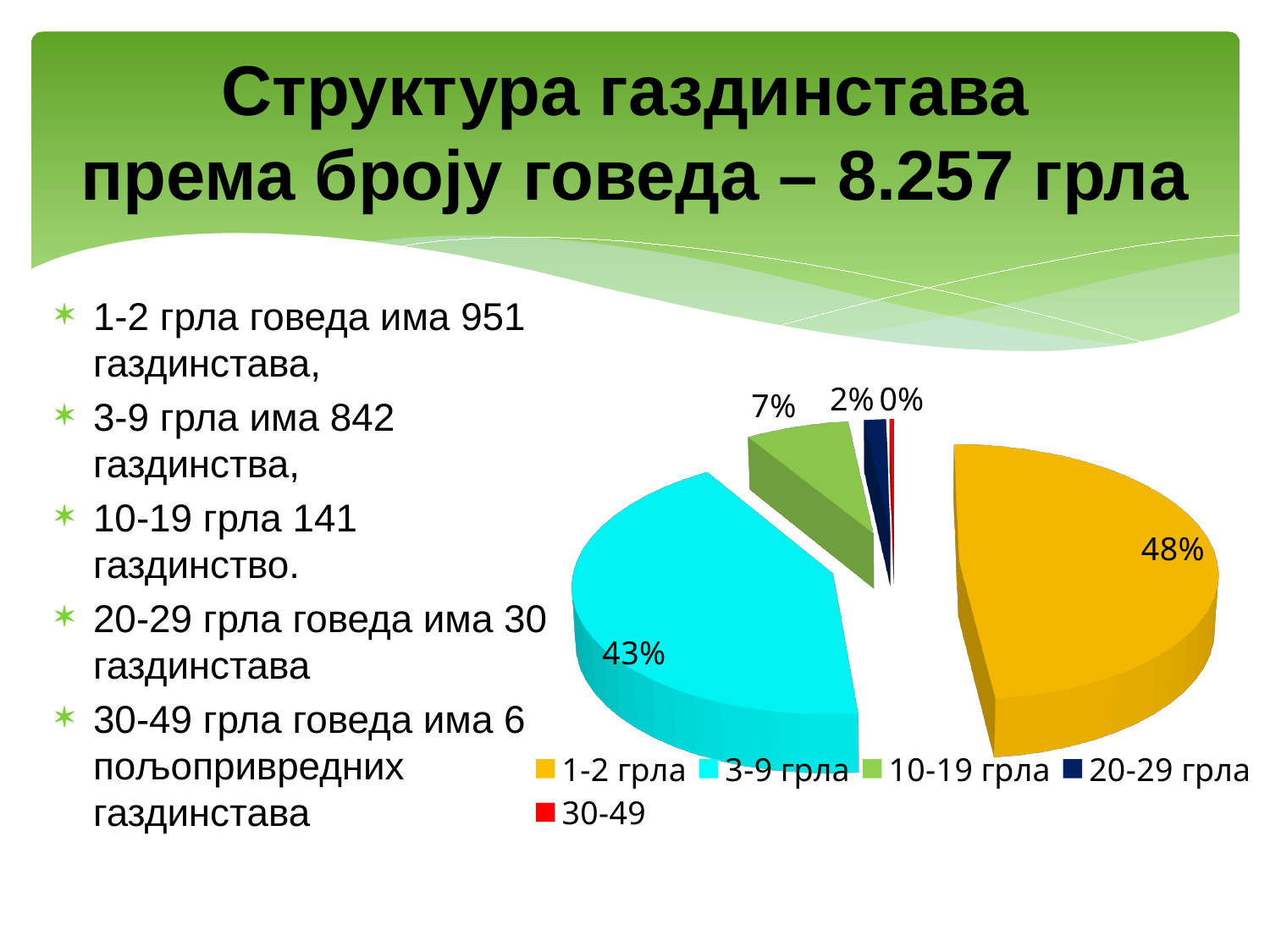
Which category has the smallest slice of the pie? 30-49 What colour is the 1-2 грла slice in the pie chart? yellow What is the value shown for the 10-19 грла slice? 7% What is the difference in percentage points between the 1-2 грла slice and the 3-9 грла slice? 5 percentage points What is the value shown for the 3-9 грла slice? 43% How many categories does the pie chart have? 5 What is the value shown for the 20-29 грла slice? 2% What kind of chart is shown on the slide? pie chart What share of the pie does the 1-2 грла slice represent? 48% What is the value shown for the 30-49 slice? 0% Which category has the largest slice of the pie? 1-2 грла Which slice is larger, 3-9 грла or 10-19 грла? 3-9 грла